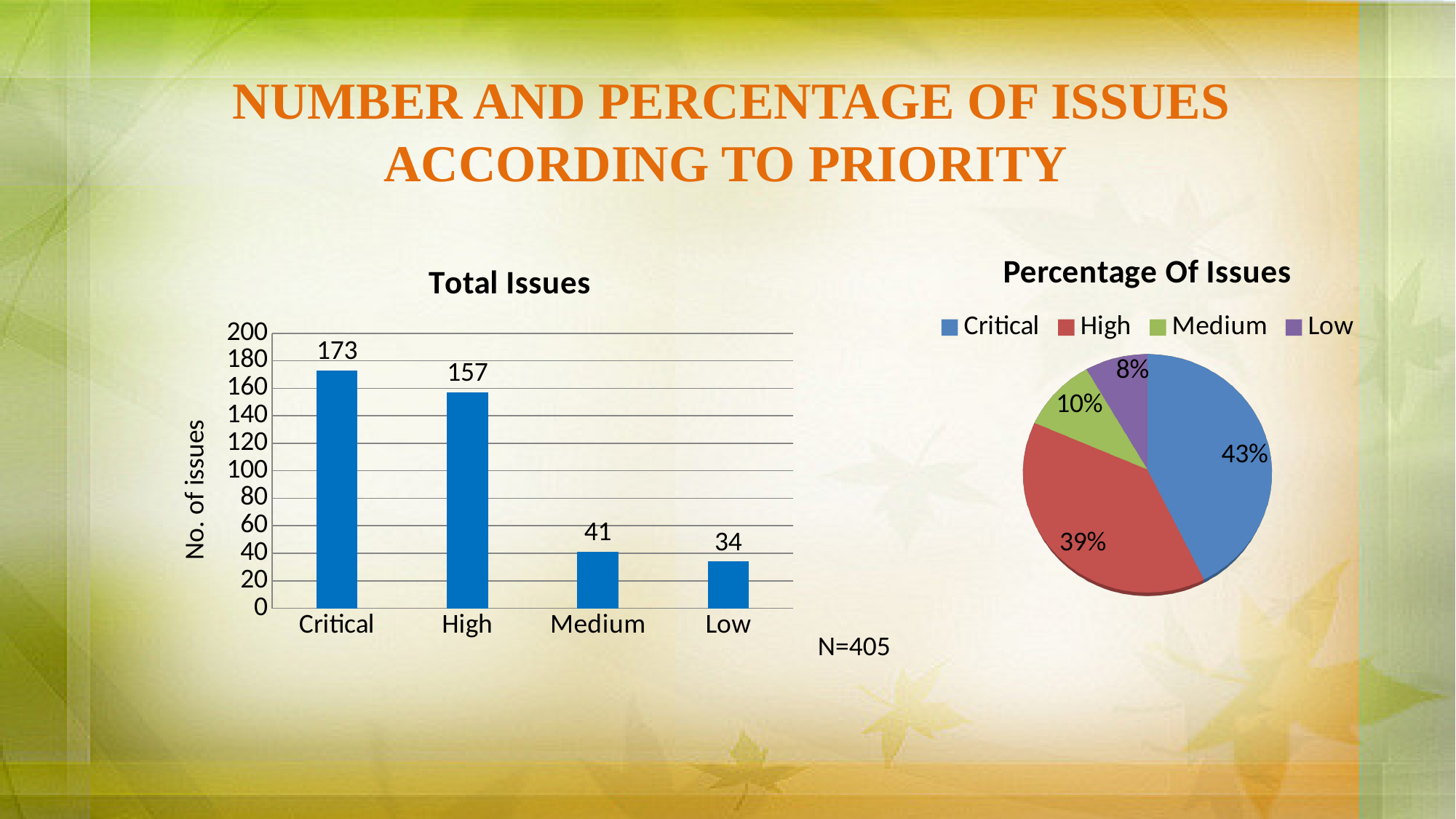
In the "Percentage Of Issues" chart, what share does the High slice have? 39% How many categories are shown in the "Total Issues" chart? 4 In the "Total Issues" chart, which category has the lowest number of issues? Low In the "Total Issues" chart, what is the difference between the values for Critical and High? 16 In the "Total Issues" chart, which is larger, the value for Medium or the value for Low? Medium How many entries does the legend of the "Percentage Of Issues" chart list? 4 What is the axis title on the vertical axis of the "Total Issues" chart? No. of issues In the "Total Issues" chart, which category has the highest number of issues? Critical In the "Total Issues" chart, what is the value for Medium? 41 In the "Percentage Of Issues" chart, what share does the Low slice have? 8% What kind of chart is the "Total Issues" chart? Bar chart In the "Total Issues" chart, what is the value for Critical? 173